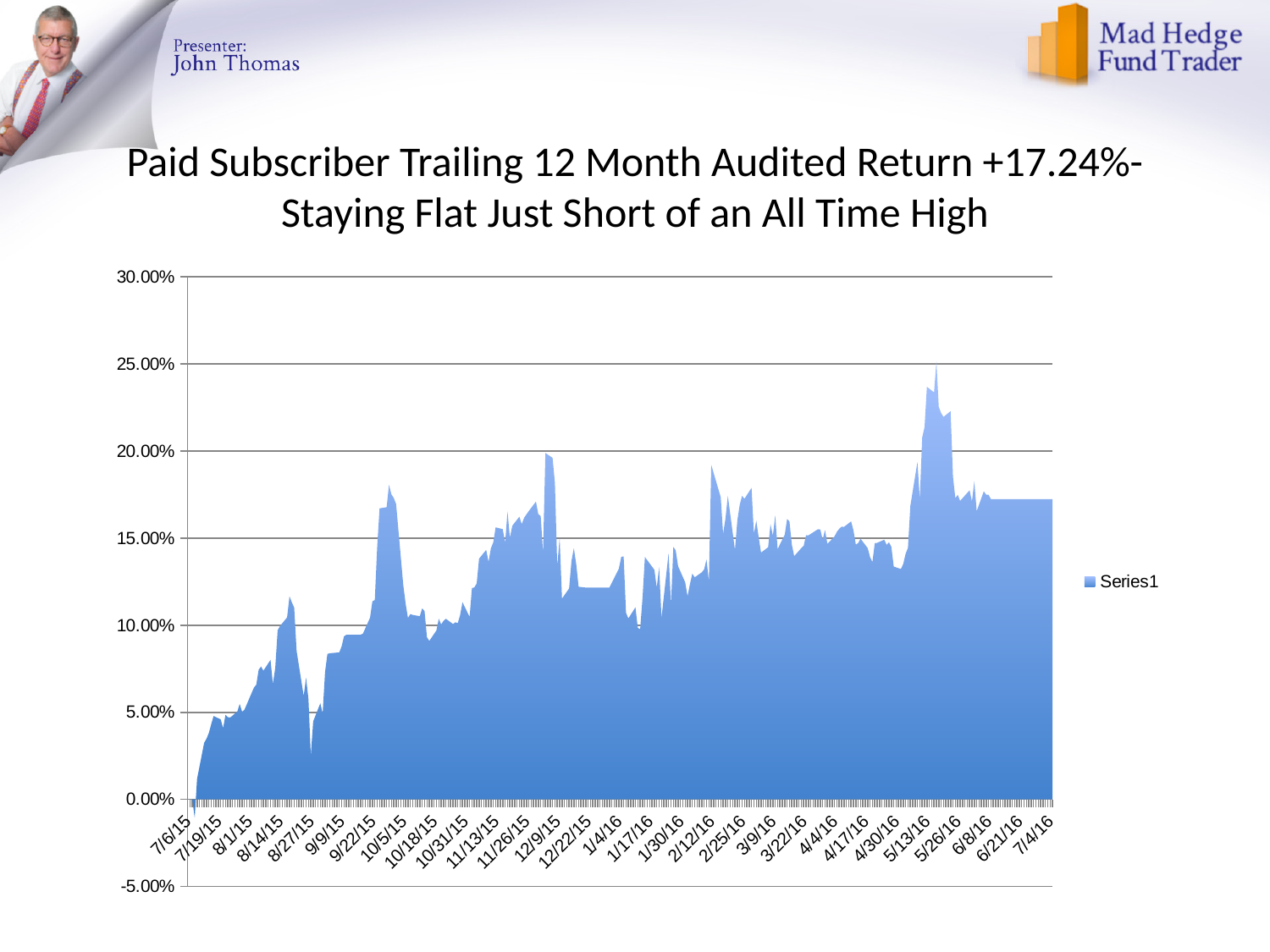
Overall, do the values rise or fall from 7/6/15 to 7/4/16? rise Is the value at 7/4/16 greater or less than 20.00%? less Which is larger, the value at 7/6/15 or the value at 7/4/16? 7/4/16 What kind of chart is shown on the slide? area chart Is the value at 4/30/16 greater or less than 10.00%? greater Is the value at 8/27/15 greater or less than 5.00%? less What is the name of the series shown in the legend? Series1 How many series does the legend list? 1 What trailing 12 month audited return is stated in the chart title? +17.24%